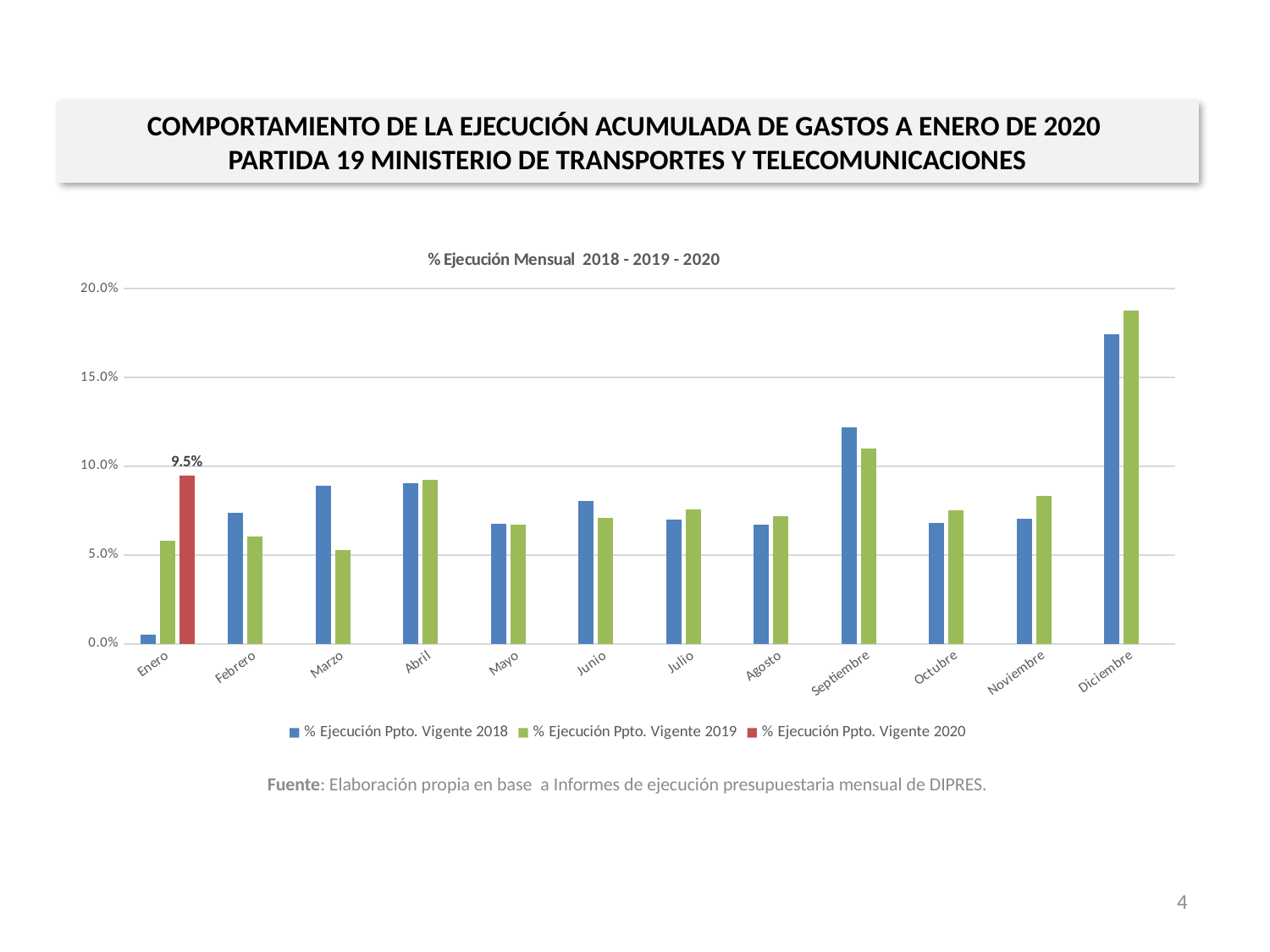
In Septiembre, which is larger: the 2018 value or the 2019 value? 2018 How many months are shown on the x axis? 12 Is the value for % Ejecución Ppto. Vigente 2018 in Enero greater or less than 5.0%? less Is the value for % Ejecución Ppto. Vigente 2019 in Diciembre greater or less than 15.0%? greater In which month is the % Ejecución Ppto. Vigente 2019 value highest? Diciembre What is the title of the chart? % Ejecución Mensual 2018 - 2019 - 2020 What kind of chart is shown on the slide? Bar chart What is the value for % Ejecución Ppto. Vigente 2020 in Enero? 9.5% In Marzo, which is larger: the 2018 value or the 2019 value? 2018 In which month is the % Ejecución Ppto. Vigente 2018 value highest? Diciembre How many series does the legend list? 3 In which month is the % Ejecución Ppto. Vigente 2018 value lowest? Enero